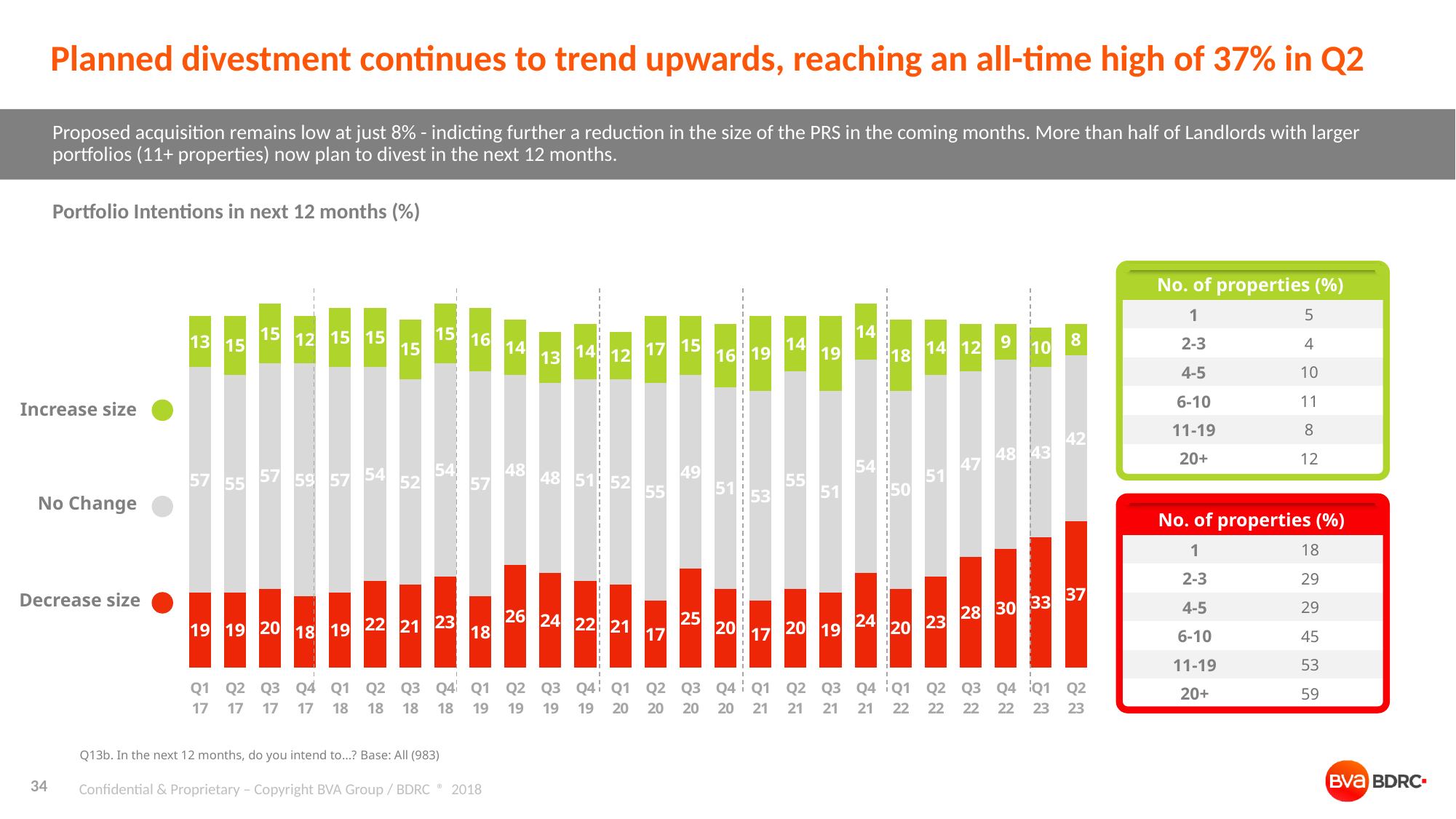
How many quarters are shown on the x axis? 26 What is the No Change value for Q4 17? 59 What is the difference between the Decrease size values for Q2 23 and Q1 23? 4 What kind of chart is shown? Stacked bar chart Does the Decrease size value rise or fall from Q1 22 to Q2 23? Rise What is the total of the stacked bar for Q2 23? 87 Which quarter has the highest Decrease size value? Q2 23 What is the Increase size value for Q1 21? 19 What is the Decrease size value for Q2 23? 37 Which quarter has the lowest Increase size value? Q2 23 Which is larger, the Increase size value for Q1 21 or for Q2 21? Q1 21 How many series does the legend list? 3